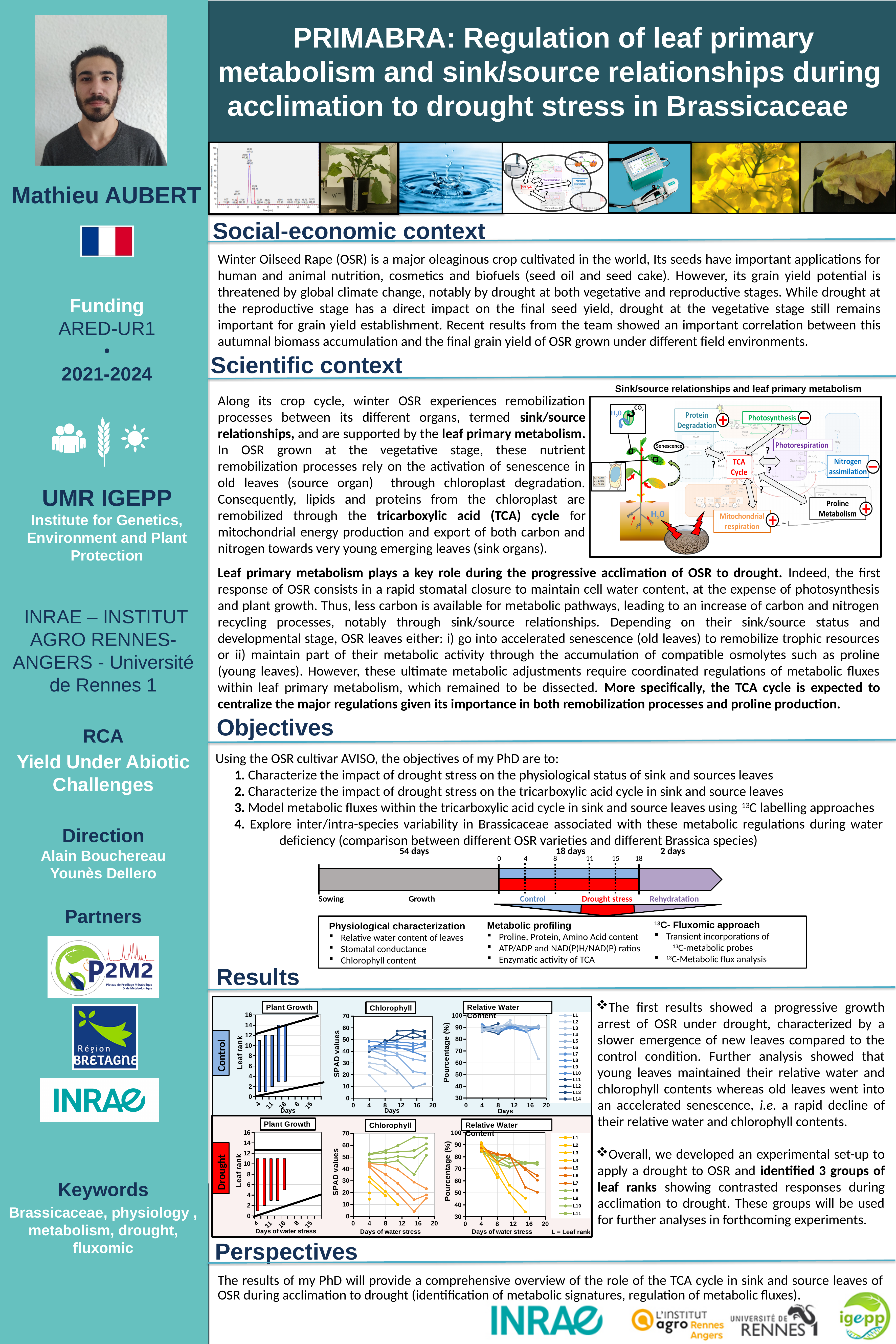
In the Drought Relative Water Content chart, do the values for most leaf ranks rise or fall along the x axis? fall How many leaf-rank series does the legend list for the Drought charts in the Results section? 11 What is the y-axis label of the Chlorophyll charts in the Results section? SPAD values What is the lowest tick value shown on the y axis of the Relative Water Content charts? 30 What is the highest tick value shown on the y axis of the Chlorophyll charts? 70 In the Results section, what kind of chart is the Plant Growth chart under the Control condition? bar chart In the Results section, what kind of chart is the Chlorophyll chart under the Drought condition? line chart What is the highest tick value shown on the y axis (Leaf rank) of the Plant Growth charts? 16 How many leaf-rank series does the legend list for the Control charts in the Results section? 14 What is the x-axis label of the Drought charts in the Results section? Days of water stress